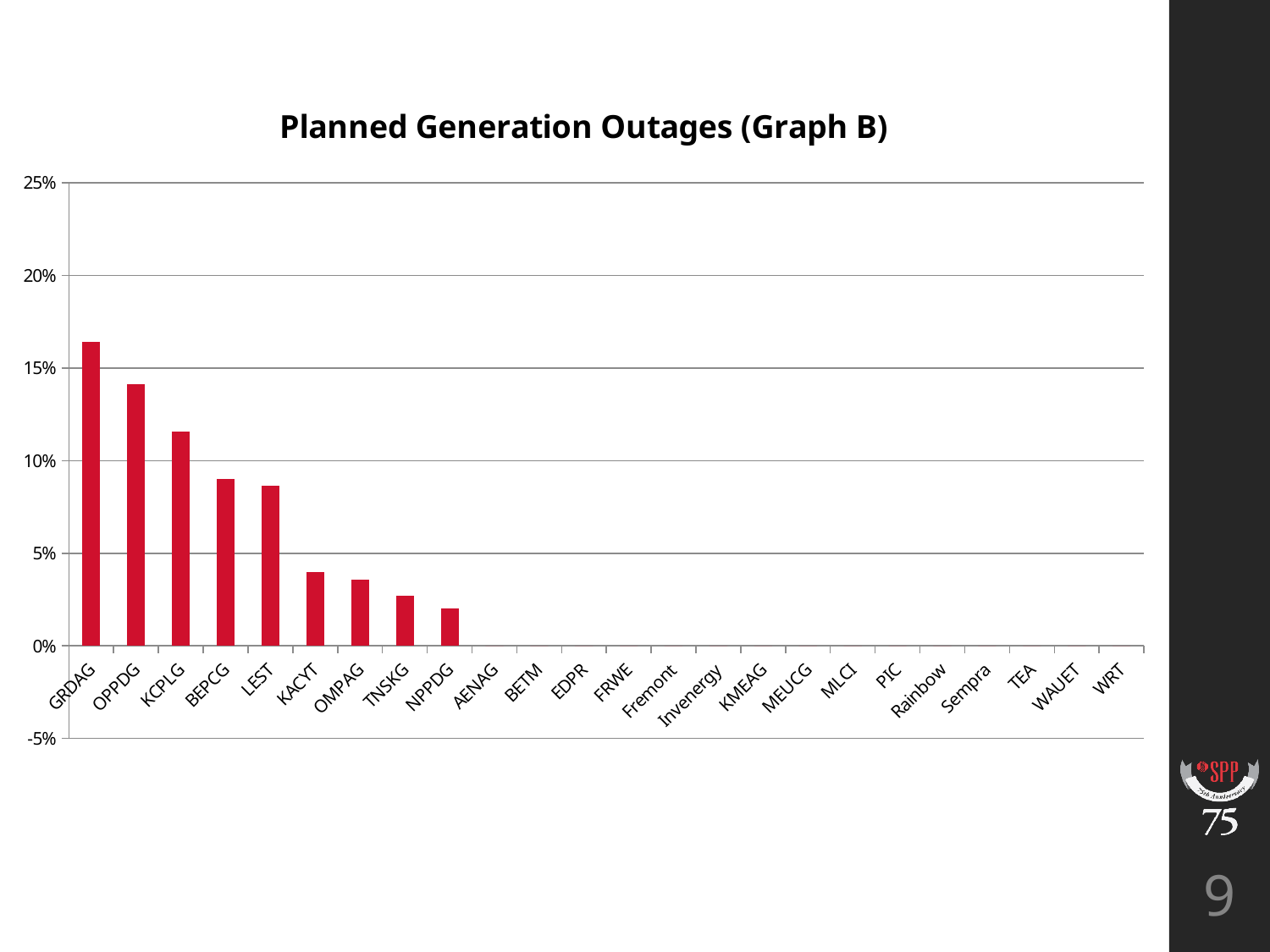
Is the value for KCPLG greater or less than 10%? greater Is the value for KACYT greater or less than 5%? less Is the value for GRDAG greater or less than 15%? greater Which has a larger value, GRDAG or OPPDG? GRDAG What type of chart is shown on the slide? bar chart Do the bar values rise or fall moving from left to right along the x axis? fall Which category has the highest planned generation outage percentage? GRDAG How many categories are shown on the x axis of the chart? 24 What is the title of the chart? Planned Generation Outages (Graph B) Which has a larger value, KACYT or NPPDG? KACYT